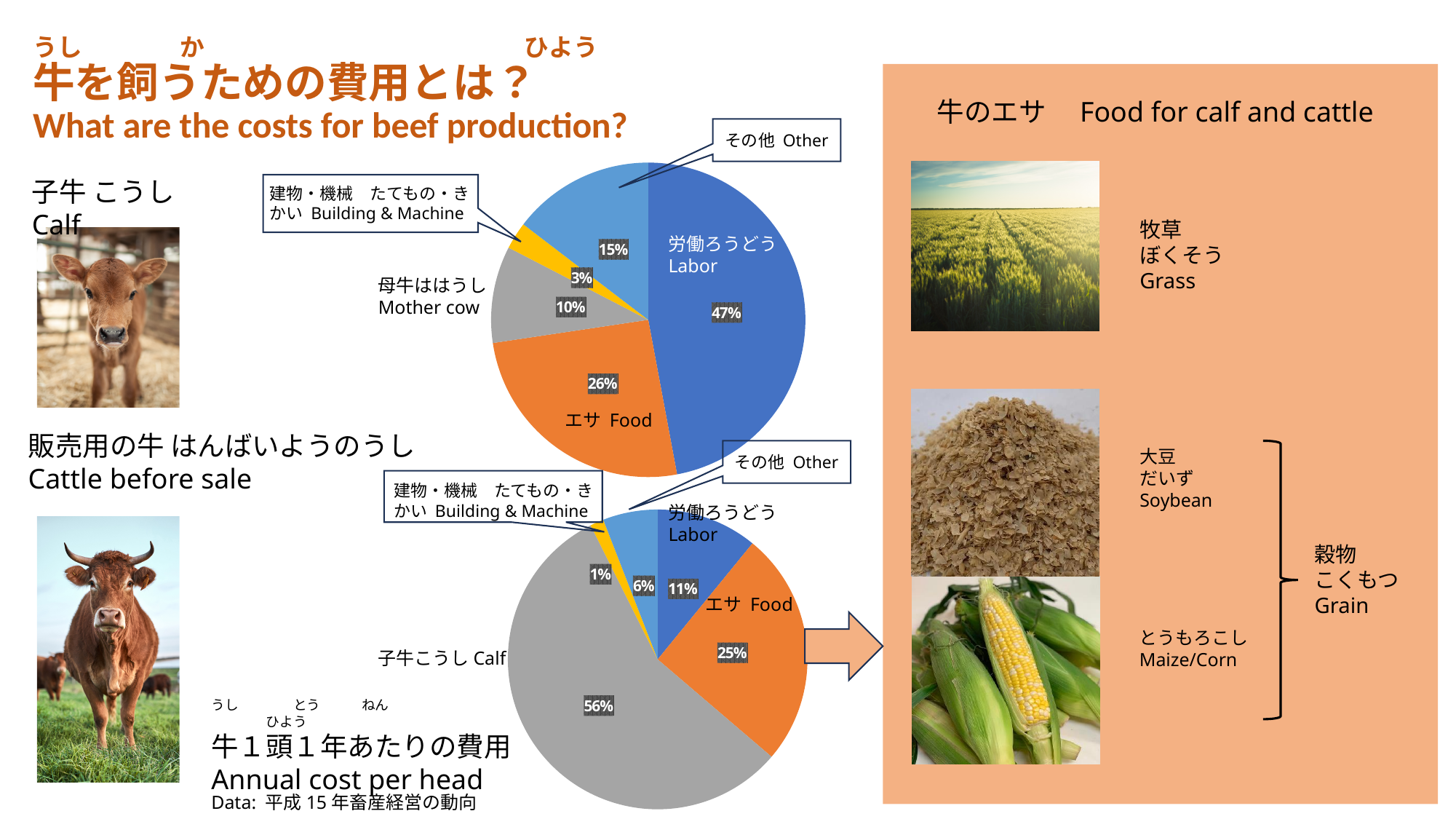
In the Cattle before sale pie chart, which category has the largest share? Calf In the Calf pie chart, what share of the cost is Labor? 47% In the Cattle before sale pie chart, what is the difference between the Food share and the Other share? 19% In the Cattle before sale pie chart, what share of the cost is Calf? 56% In the Cattle before sale pie chart, what share of the cost is Labor? 11% In the Calf pie chart, what share of the cost is Mother cow? 10% What type of chart is used to show the annual cost per head for Calf and for Cattle before sale? Pie chart In the Calf pie chart, which category has the largest share? Labor How many categories does the Calf pie chart show? 5 In the Calf pie chart, what share of the cost is Food? 26% In the Cattle before sale pie chart, what share of the cost is Food? 25% In the Calf pie chart, which category has the smallest share? Building & Machine